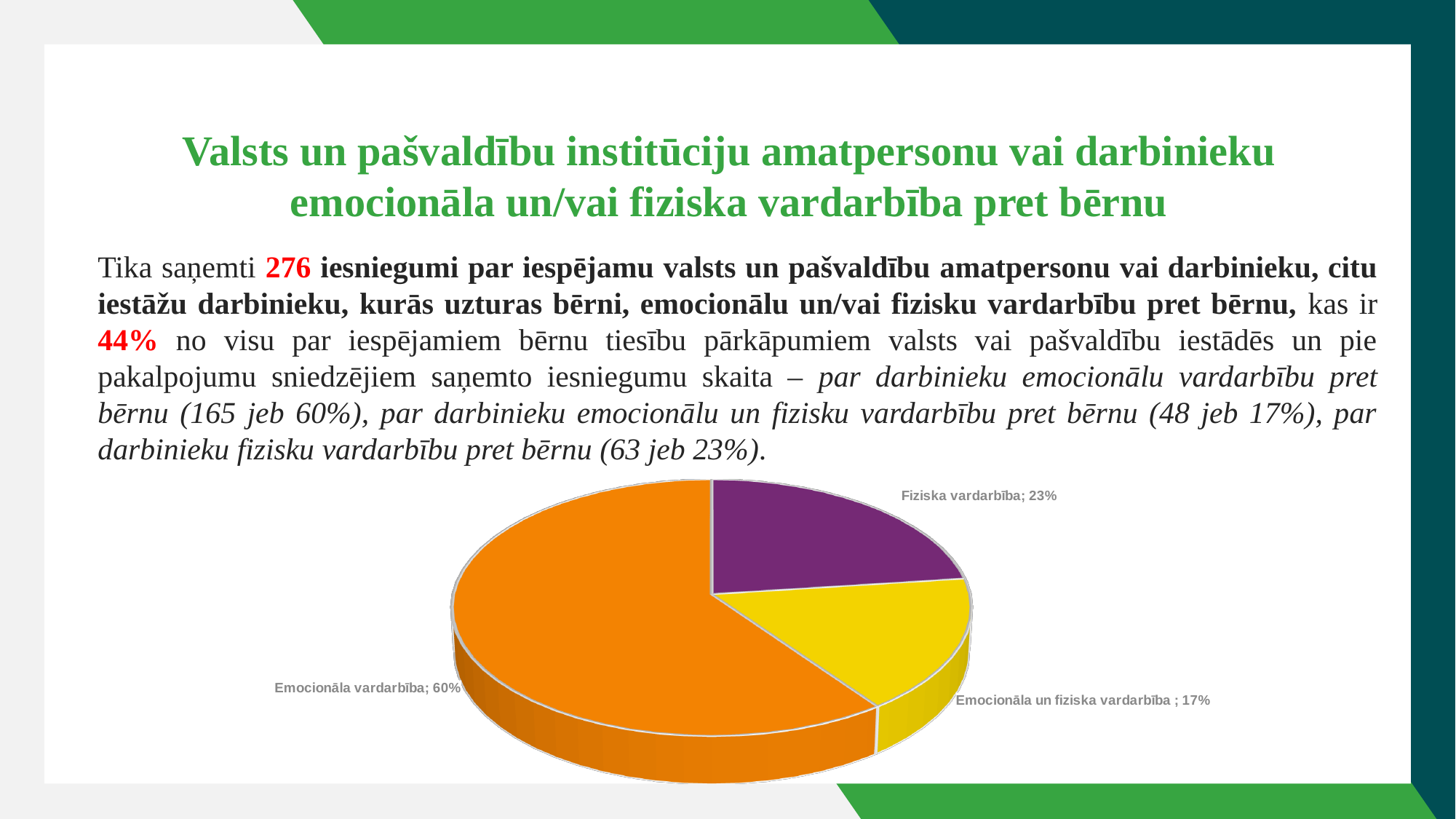
What share of the pie is labelled "Emocionāla vardarbība"? 60% How many slices does the pie chart have? 3 Which slice of the pie chart is the smallest? Emocionāla un fiziska vardarbība Which is larger in the pie chart: "Fiziska vardarbība" or "Emocionāla un fiziska vardarbība"? Fiziska vardarbība What is the difference in percentage points between the "Emocionāla vardarbība" slice and the "Fiziska vardarbība" slice? 37 What is the difference in percentage points between the "Fiziska vardarbība" slice and the "Emocionāla un fiziska vardarbība" slice? 6 What share of the pie is labelled "Emocionāla un fiziska vardarbība"? 17% What share of the pie is labelled "Fiziska vardarbība"? 23% What colour is the "Emocionāla vardarbība" slice in the pie chart? orange What colour is the "Fiziska vardarbība" slice in the pie chart? purple Which slice of the pie chart is the largest? Emocionāla vardarbība What kind of chart is shown on the slide? pie chart